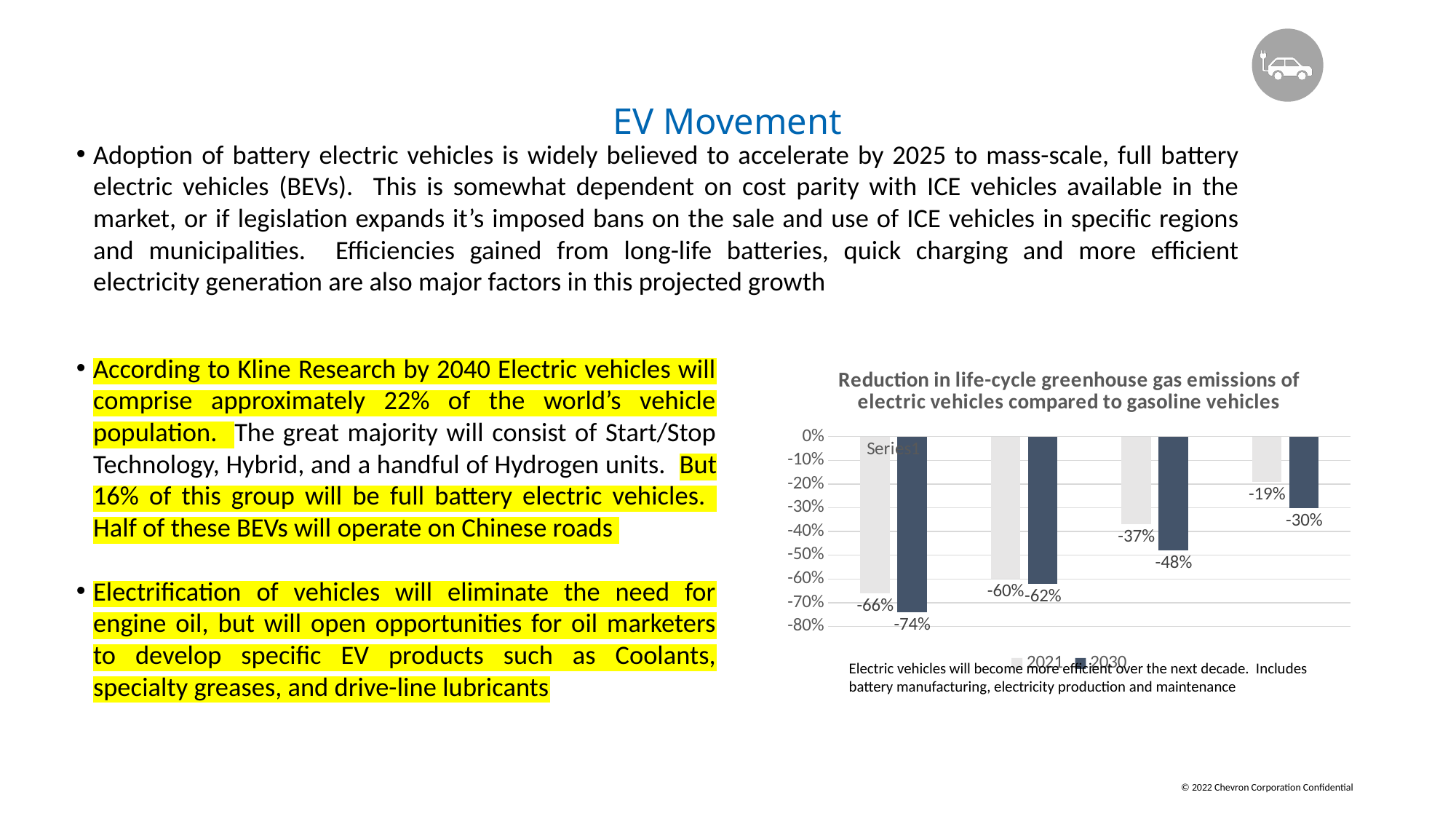
How many series does the chart legend list? 2 What is the 2030 value for the leftmost group of bars? -74% What is the 2030 value for the rightmost group of bars? -30% What is the 2021 value for the third group of bars from the left? -37% Which 2030 bar shows the largest reduction (most negative value)? The leftmost group, at -74% How many groups of bars are plotted in the chart? 4 What is the 2021 value for the leftmost group of bars? -66% What are the two series named in the chart legend? 2021 and 2030 In the third group of bars from the left, what is the difference between the 2021 value (-37%) and the 2030 value (-48%)? 11 percentage points In the second group of bars from the left, which series shows the larger reduction, 2021 or 2030? 2030 (-62%) What kind of chart is shown on the slide? Bar chart What is the title of the chart? Reduction in life-cycle greenhouse gas emissions of electric vehicles compared to gasoline vehicles